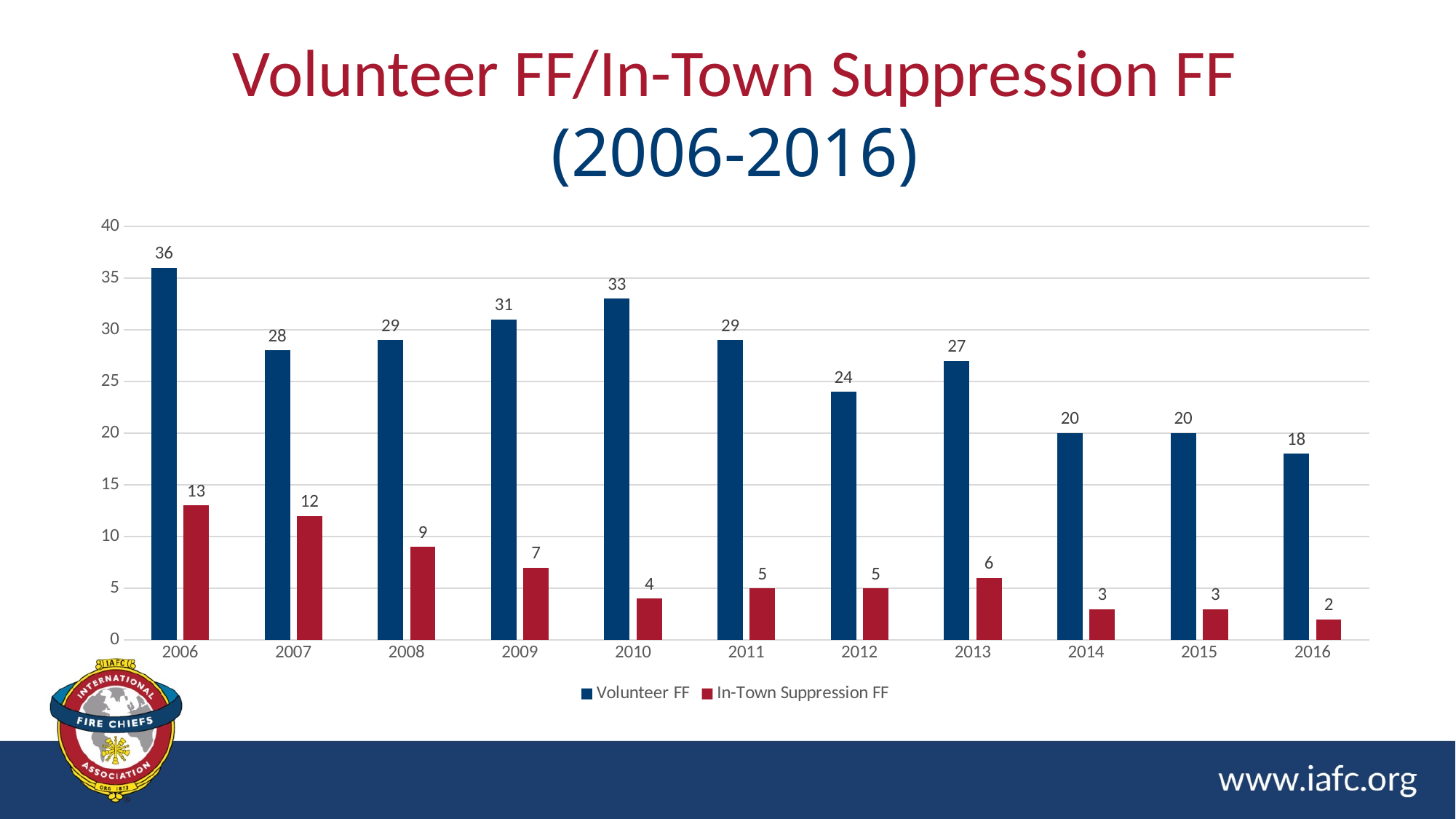
Which year has the highest Volunteer FF value? 2006 What is the difference between the Volunteer FF and In-Town Suppression FF values in 2006? 23 Do the In-Town Suppression FF values generally rise or fall from 2006 to 2016? fall What kind of chart is shown on the slide? bar chart What is the In-Town Suppression FF value for 2008? 9 Is the Volunteer FF value for 2012 greater or less than 25? less How many series does the legend list? 2 How many years are shown on the x axis? 11 Which is larger, the Volunteer FF value for 2009 or for 2011? 2009 What is the Volunteer FF value for 2010? 33 Which year has the lowest In-Town Suppression FF value? 2016 What colour are the In-Town Suppression FF bars? red